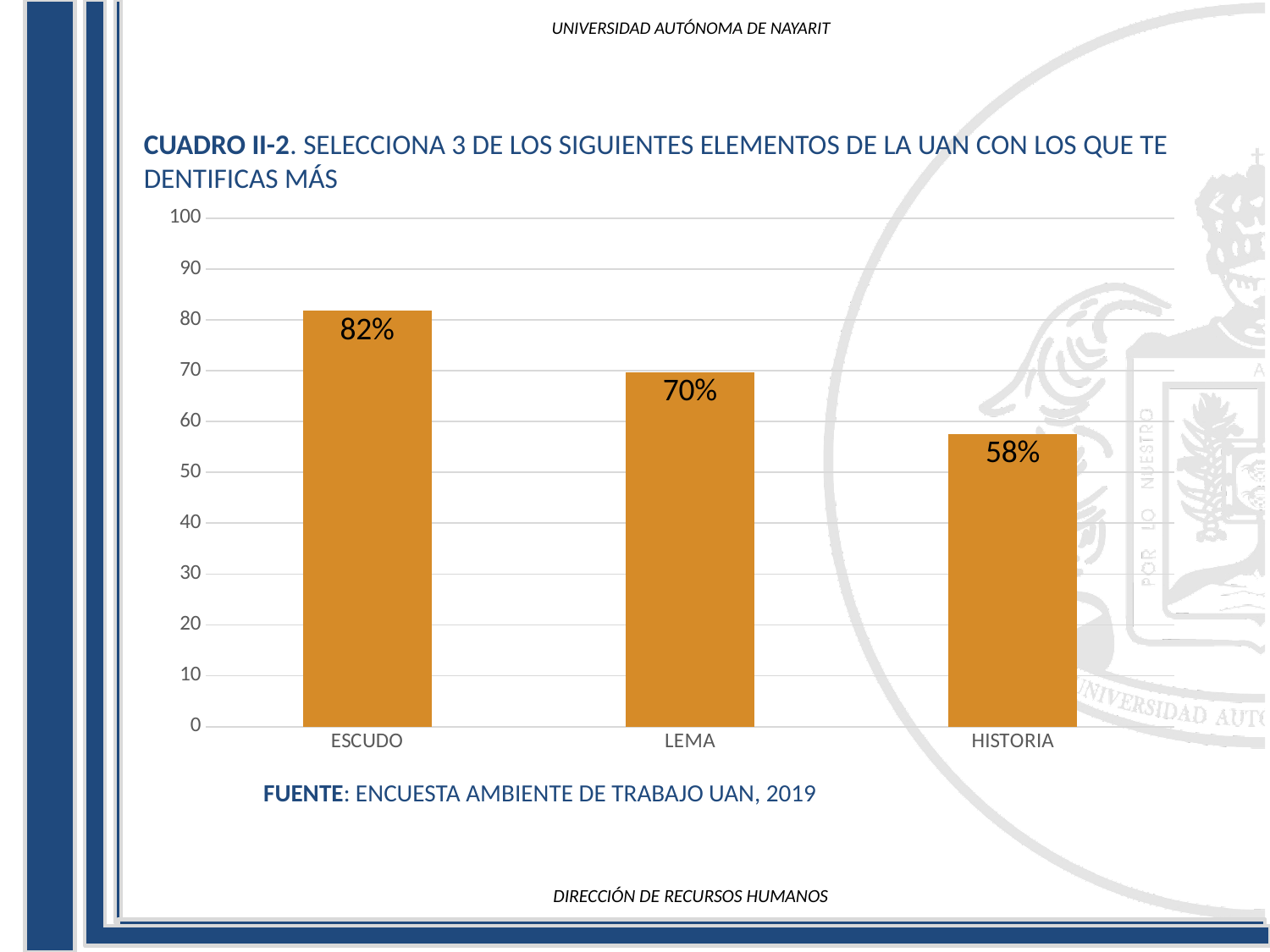
What is the difference between the values for LEMA and HISTORIA? 12% Which is larger, the value for LEMA or the value for HISTORIA? LEMA Is the value for HISTORIA greater or less than 60? less What is the value for HISTORIA? 58% How many categories are shown on the x axis? 3 What is the value for LEMA? 70% What is the difference between the values for ESCUDO and HISTORIA? 24% Do the values rise or fall from left to right along the x axis? fall Which category has the lowest value? HISTORIA What kind of chart is shown on the slide? bar chart Which category has the highest value? ESCUDO What is the value for ESCUDO? 82%